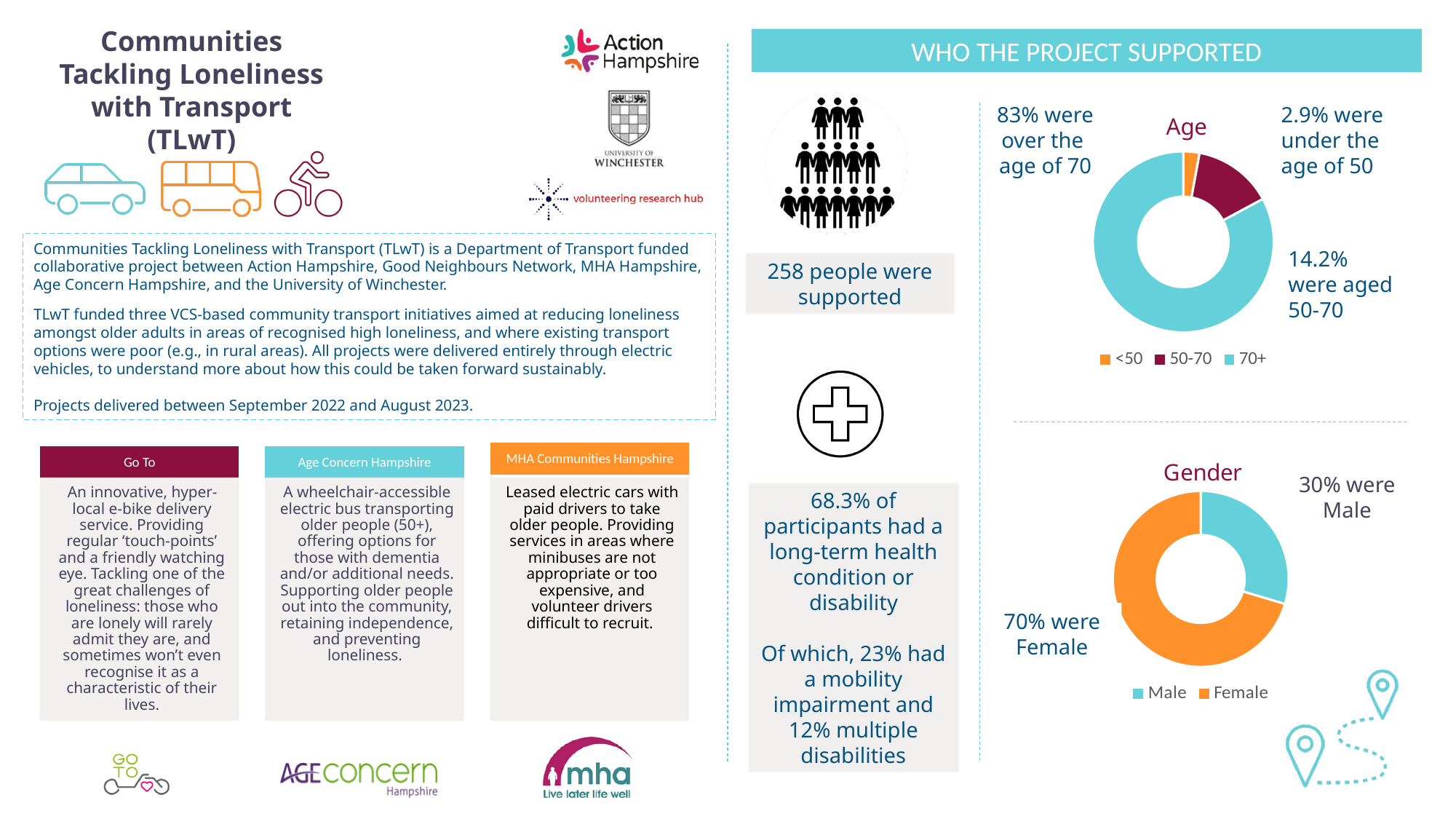
In the Gender chart, what share of people supported were Male? 30% In the Gender chart, what share of people supported were Female? 70% How many categories does the Age chart's legend list? 3 In the Age chart, which age group has the largest share? 70+ In the Gender chart, what colour represents Female? Orange In the Age chart, what is the difference in percentage points between the 50-70 group and the <50 group? 11.3 In the Age chart, what share of people supported were aged 70+? 83% In the Gender chart, which is larger, the Male share or the Female share? Female In the Age chart, what share of people supported were under the age of 50? 2.9% In the Age chart, which age group has the smallest share? <50 What kind of chart is the Age chart? Donut chart In the Age chart, what share of people supported were aged 50-70? 14.2%